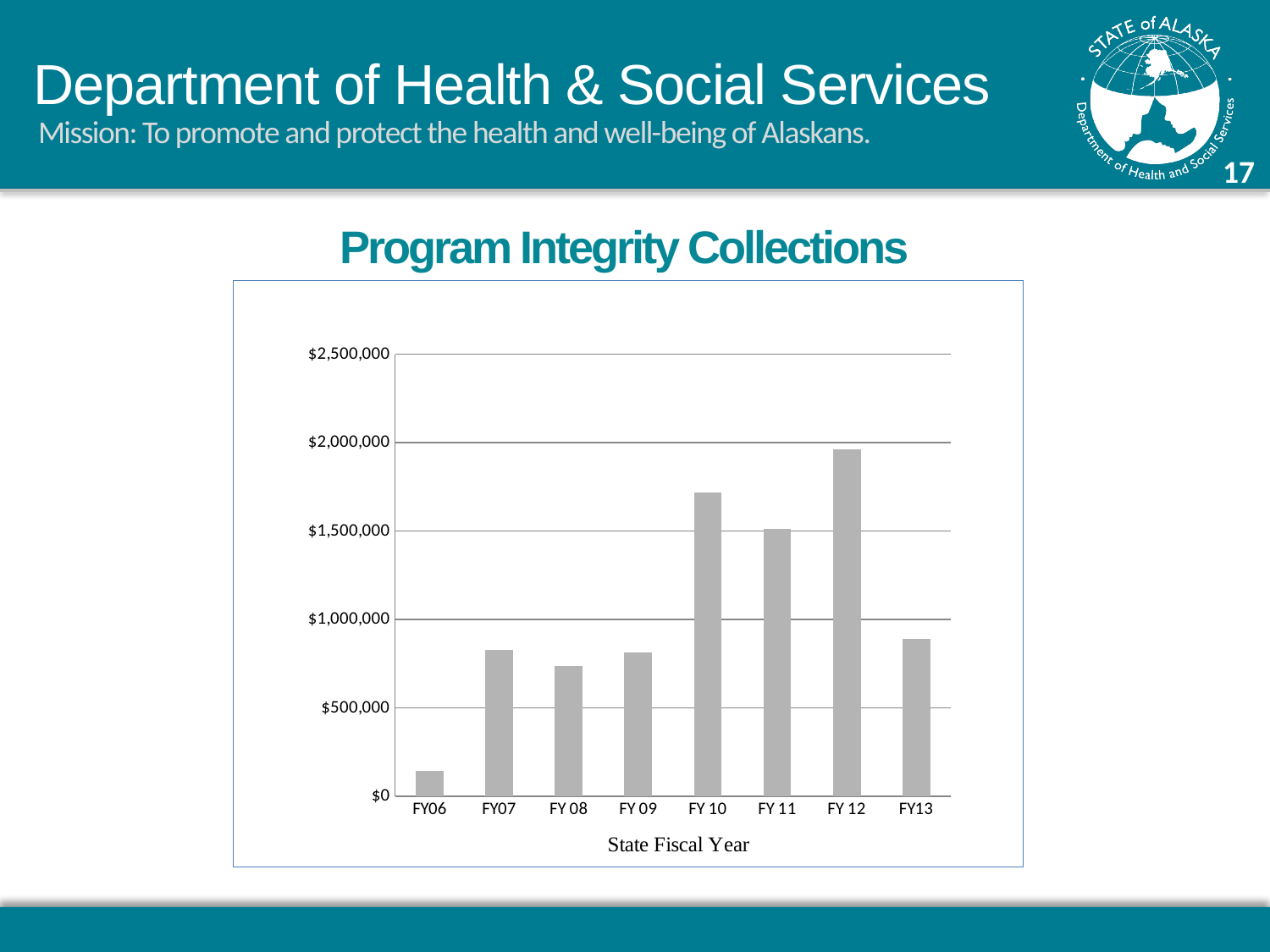
Which is larger, the value for FY 10 or the value for FY 11? FY 10 Which fiscal year has the lowest collections? FY06 Do collections rise or fall from FY 12 to FY13? fall What is the title of the chart? Program Integrity Collections How many fiscal years are plotted on the chart? 8 Is the value for FY13 greater or less than $1,000,000? less What is the label on the x axis of the chart? State Fiscal Year Is the value for FY 10 greater or less than $1,500,000? greater What kind of chart is shown on the slide? Bar chart Is the value for FY06 greater or less than $500,000? less Which fiscal year has the highest collections? FY 12